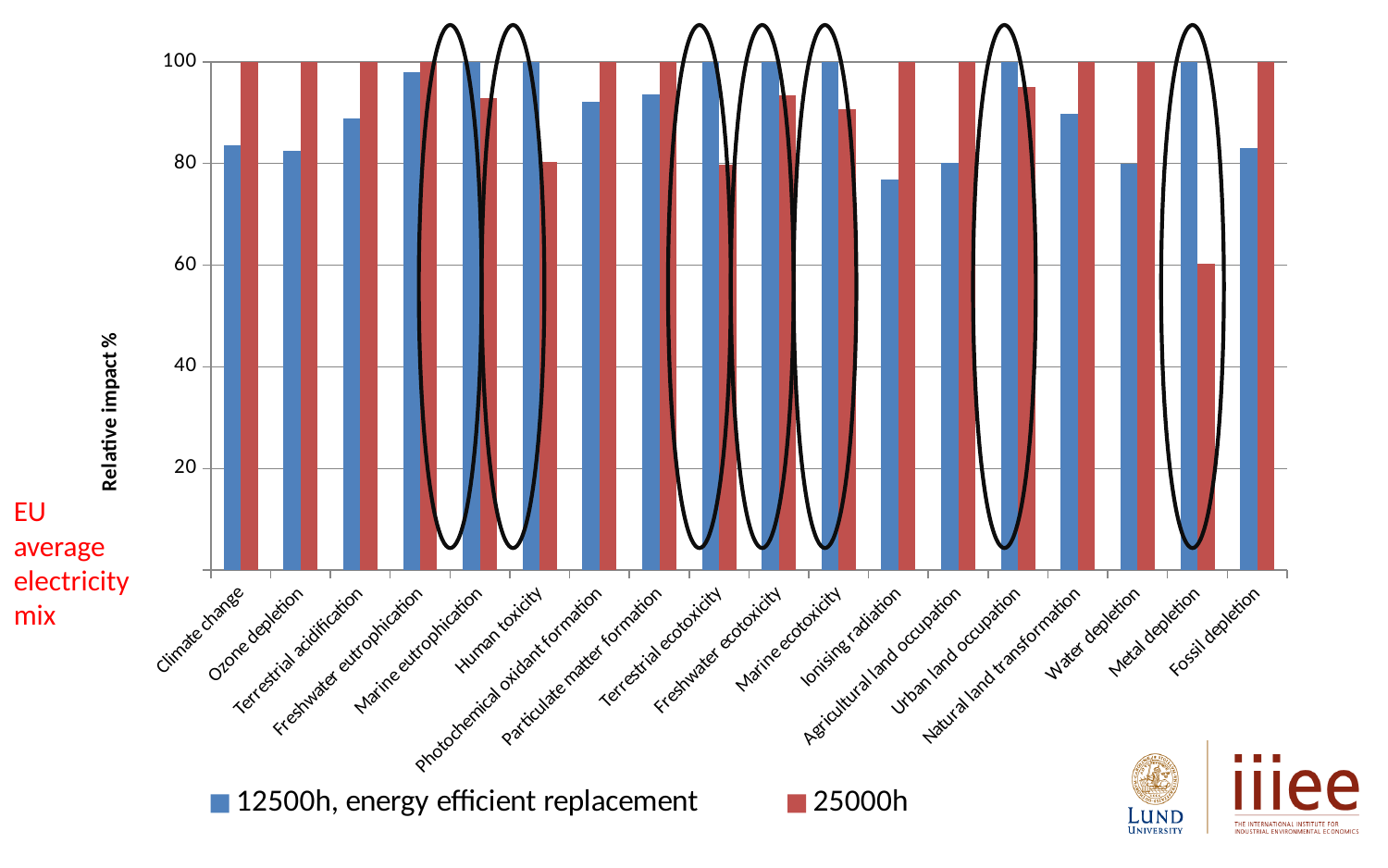
Is the value of the 12500h, energy efficient replacement series for Climate change greater or less than 80? greater What is the title of the y axis? Relative impact % What type of chart is shown on the slide? bar chart Is the value of the 25000h series for Freshwater ecotoxicity greater or less than 80? greater For Climate change, which series has the larger value? 25000h What is the value of the 12500h, energy efficient replacement series for Human toxicity? 100 How many impact categories are shown on the x axis? 18 Is the value of the 12500h, energy efficient replacement series for Terrestrial acidification greater or less than 80? greater For Metal depletion, which series has the larger value? 12500h, energy efficient replacement How many series does the legend list? 2 What is the value of the 25000h series for Climate change? 100